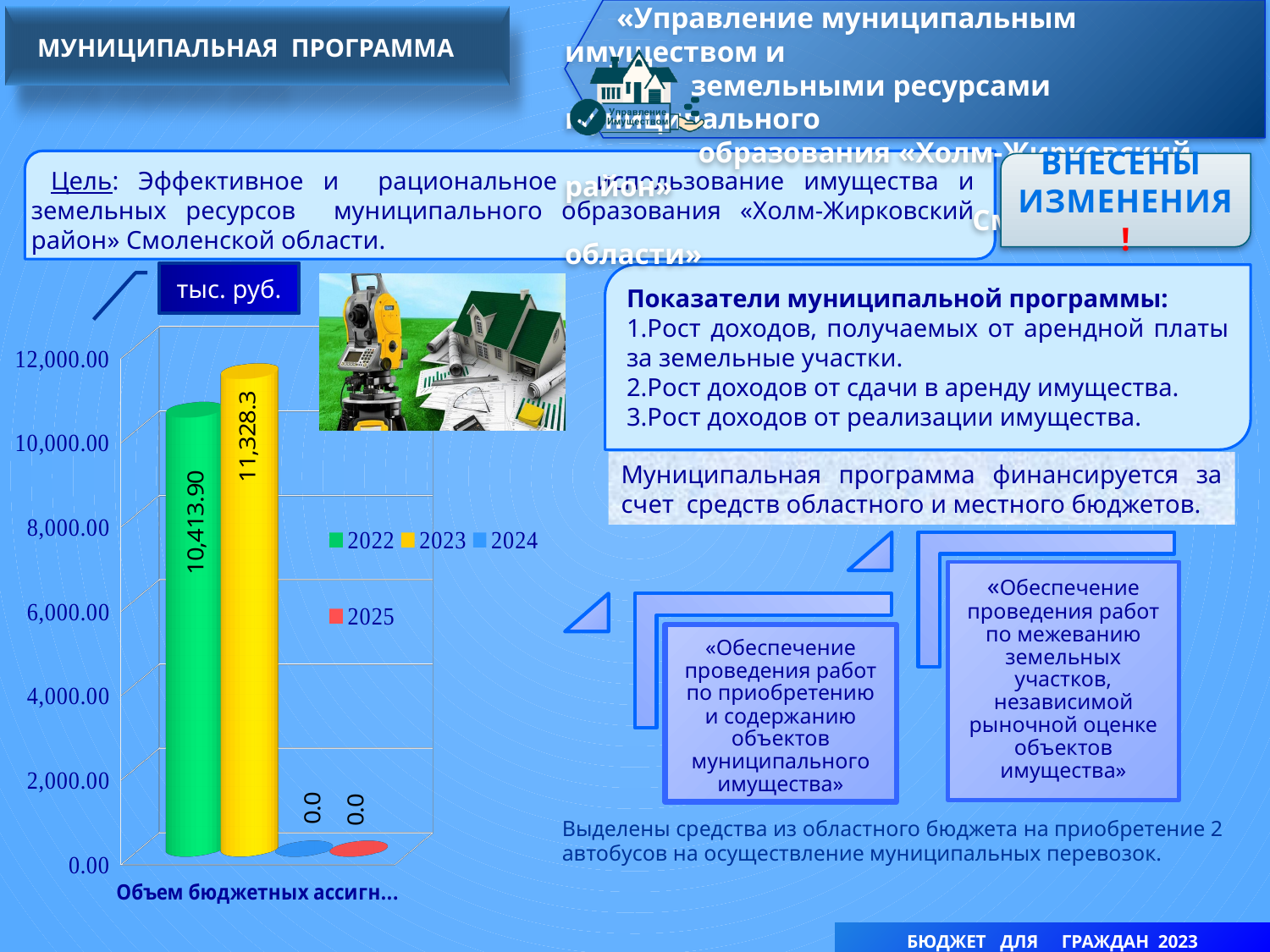
What is the value for the 2025 series in the bar chart? 0.0 Which series has the highest value in the bar chart? 2023 What unit is indicated for the values in the chart? тыс. руб. Is the value for 2022 greater or less than 10,000.00? greater What kind of chart is shown on the slide? bar chart Is the value for 2023 greater or less than 12,000.00? less Which of the two series, 2022 or 2023, has the larger value? 2023 What is the difference between the 2023 value and the 2022 value? 914.4 What is the value for the 2024 series in the bar chart? 0.0 What is the value for the 2022 series in the bar chart? 10,413.90 How many series does the legend of the chart list? 4 What is the value for the 2023 series in the bar chart? 11,328.3